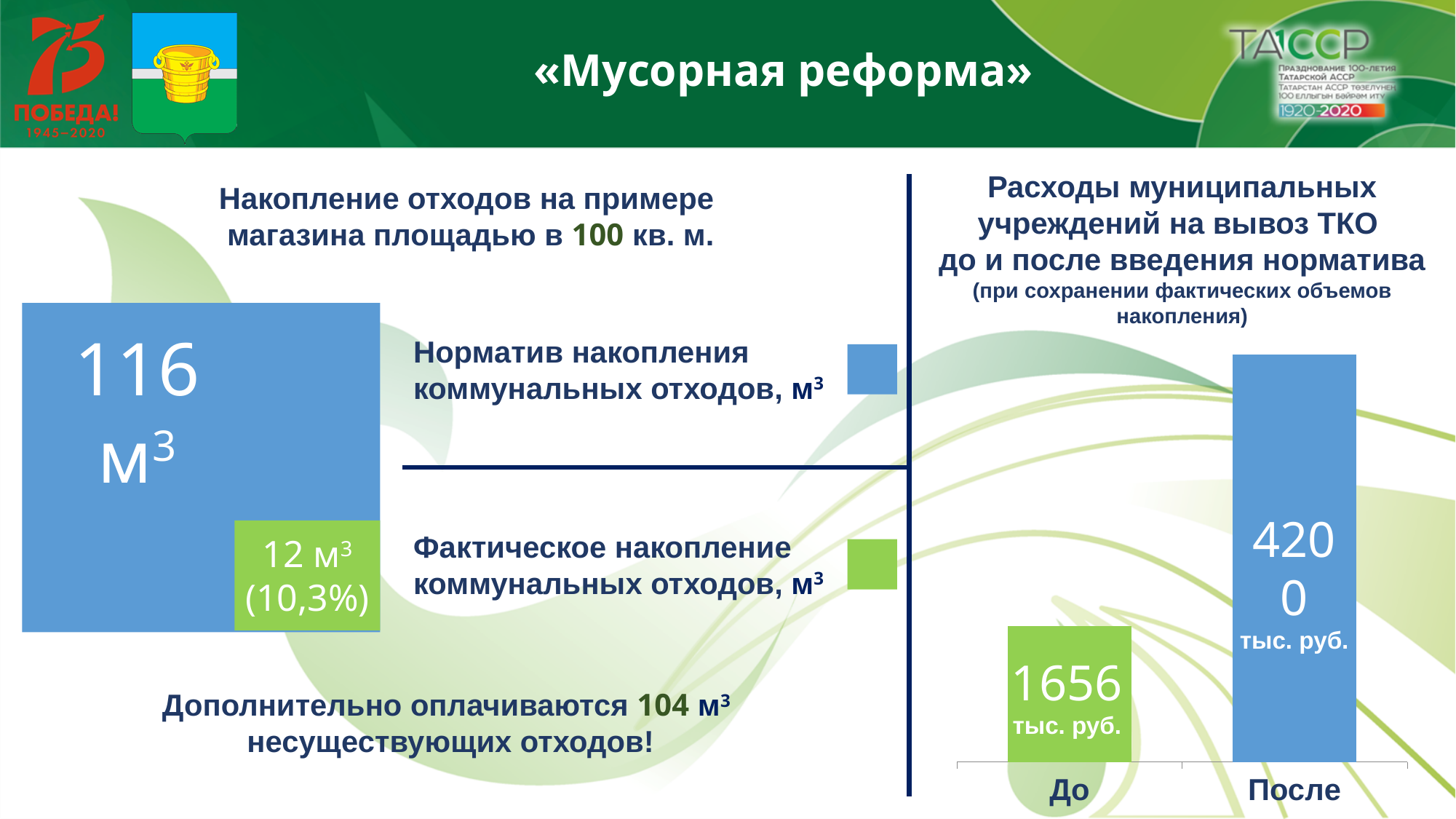
On the left-hand chart, what is the difference between the норматив (116 м³) and the фактическое накопление (12 м³)? 104 м³ On the left-hand chart, what is the value for «Фактическое накопление коммунальных отходов»? 12 м³ On the left-hand chart (Накопление отходов на примере магазина площадью в 100 кв. м.), what is the value for «Норматив накопления коммунальных отходов»? 116 м³ On the left-hand chart, which colour represents «Фактическое накопление коммунальных отходов»? Green On the right-hand chart (Расходы муниципальных учреждений на вывоз ТКО), what is the value for «После»? 4200 тыс. руб. On the right-hand chart, what is the difference between the «После» and «До» values? 2544 тыс. руб. On the left-hand chart, what share of the норматив does the фактическое накопление represent? 10,3% On the right-hand chart, which category has the lowest value? До On the right-hand chart, which category has the higher value, «До» or «После»? После How many categories are shown on the right-hand chart? 2 What kind of chart is shown on the right-hand side of the slide? Bar chart On the right-hand chart (Расходы муниципальных учреждений на вывоз ТКО), what is the value for «До»? 1656 тыс. руб.